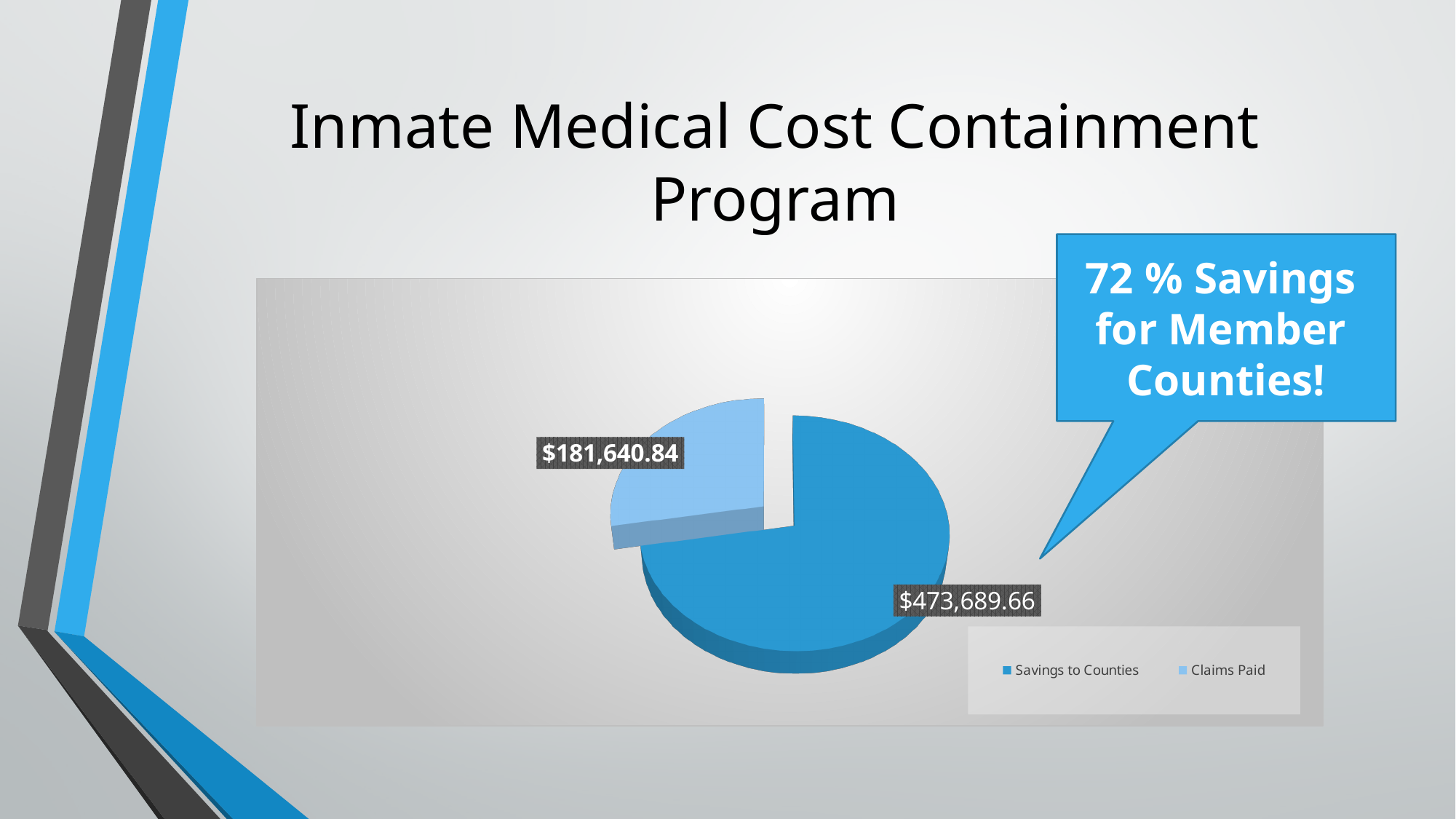
Which slice of the pie chart is the largest? Savings to Counties What kind of chart is shown on the slide? Pie chart What is the difference between the Savings to Counties value and the Claims Paid value? $292,048.82 Which is larger, Savings to Counties or Claims Paid? Savings to Counties How many slices does the pie chart have? 2 What is the value of the Savings to Counties slice in the pie chart? $473,689.66 What is the total of the two slices in the pie chart? $655,330.50 How many entries does the chart legend list? 2 Which legend entry is shown in the lighter blue colour? Claims Paid What share of the pie does the Savings to Counties slice represent? 72% What is the value of the Claims Paid slice in the pie chart? $181,640.84 Which slice of the pie chart is the smallest? Claims Paid